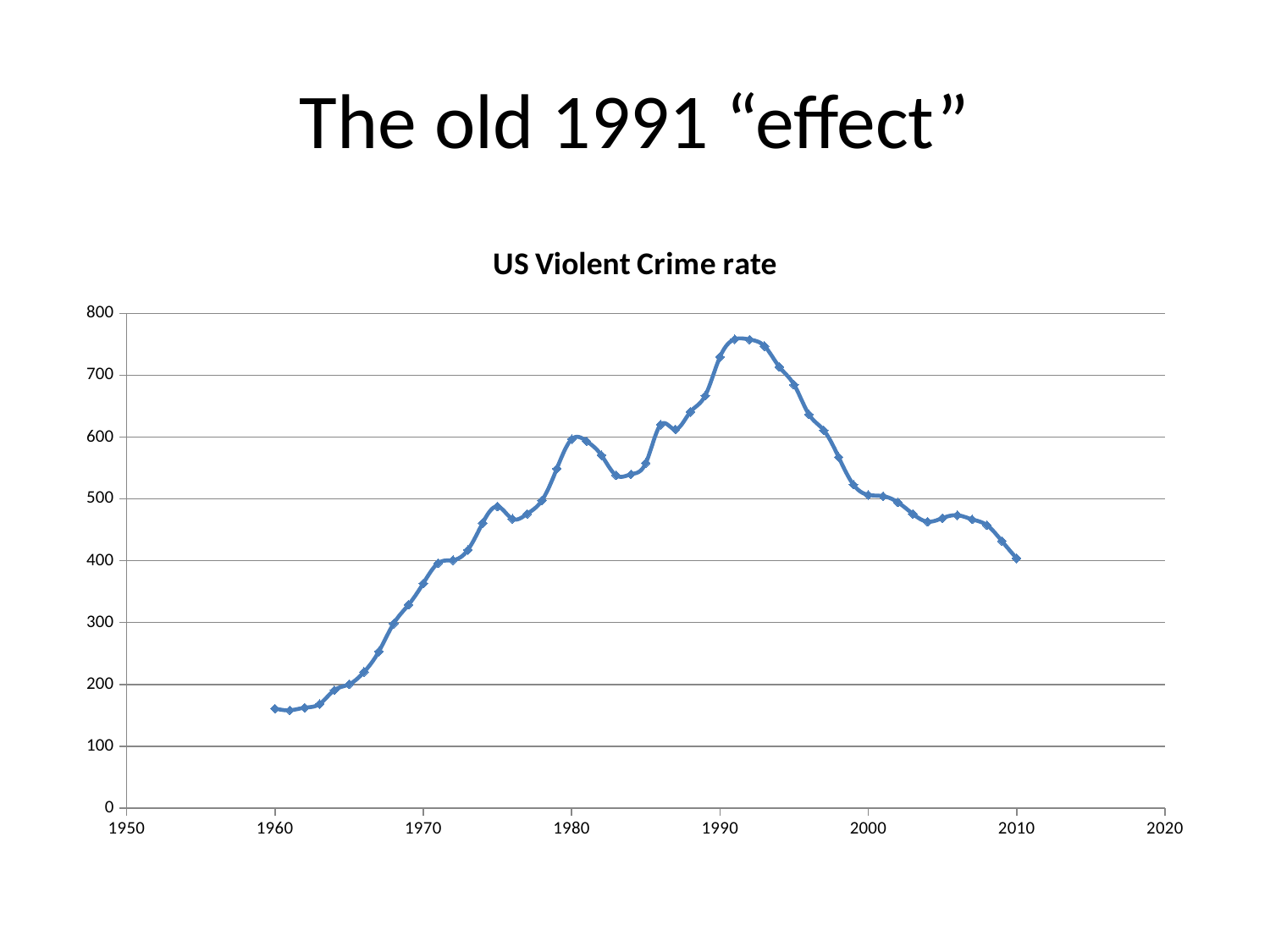
Does the violent crime rate generally rise or fall between 1991 and 2010? fall Is the value for 1970 greater or less than 400? less In which year does the US Violent Crime rate reach its highest value? 1991 What is the title of the chart? US Violent Crime rate Is the value for 1990 greater or less than 700? greater Is the value for 1965 greater or less than 300? less Which year has the higher violent crime rate, 1980 or 2000? 1980 Does the violent crime rate generally rise or fall between 1960 and 1991? rise What kind of chart is shown on the slide? line chart